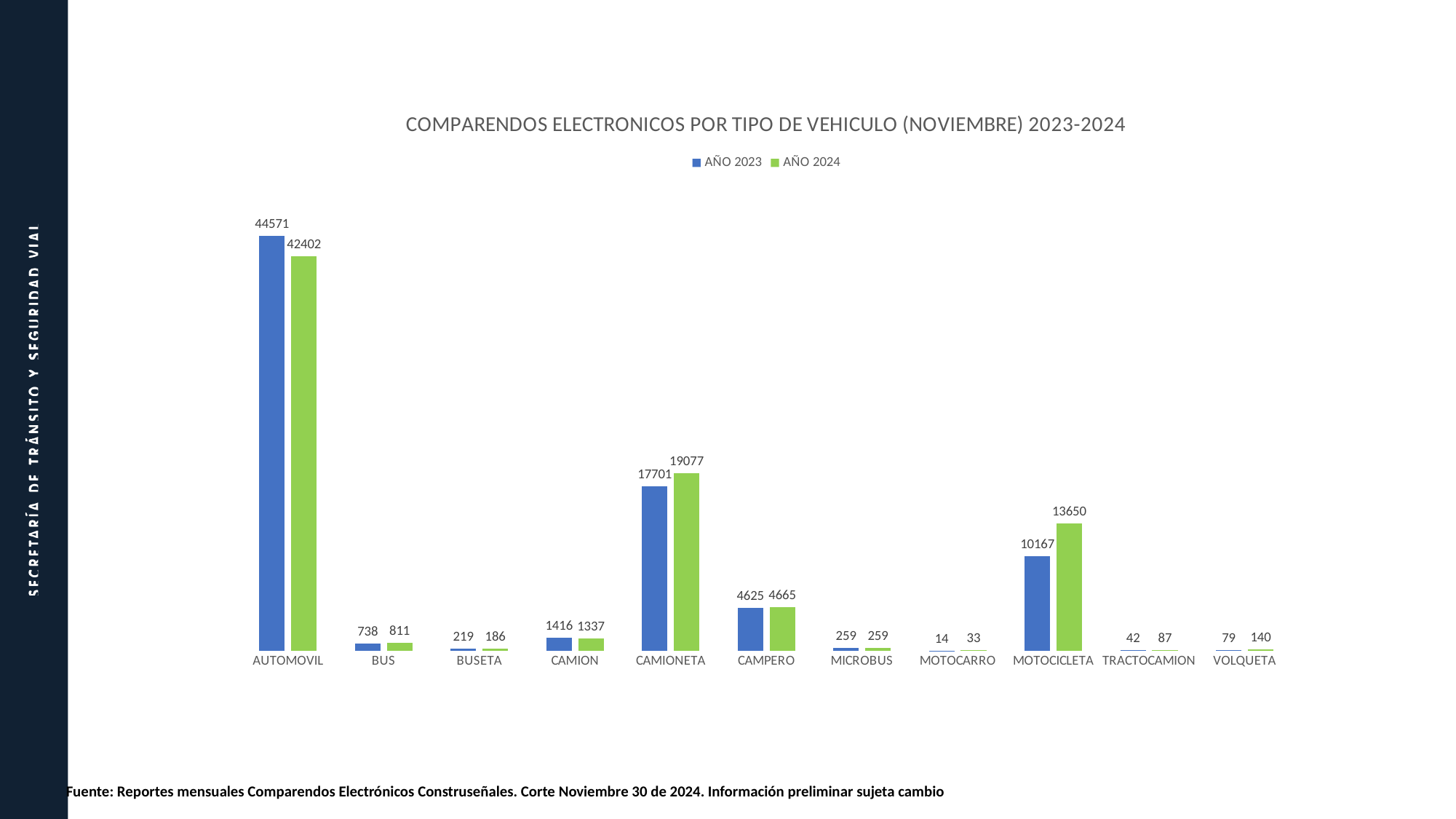
What is the value for CAMIONETA in AÑO 2023? 17701 What is the value for AUTOMOVIL in AÑO 2023? 44571 What is the value for MOTOCICLETA in AÑO 2024? 13650 Which is larger for CAMIONETA: the AÑO 2023 value or the AÑO 2024 value? AÑO 2024 What kind of chart is shown on the slide? Bar chart What is the difference between the AÑO 2023 and AÑO 2024 values for AUTOMOVIL? 2169 Which vehicle type has the lowest value in AÑO 2023? MOTOCARRO Which vehicle type has the highest value in AÑO 2024? AUTOMOVIL What is the title of the chart? COMPARENDOS ELECTRONICOS POR TIPO DE VEHICULO (NOVIEMBRE) 2023-2024 How many series does the legend list? 2 How many vehicle types are shown on the x axis? 11 What is the difference between the AÑO 2024 and AÑO 2023 values for MOTOCICLETA? 3483